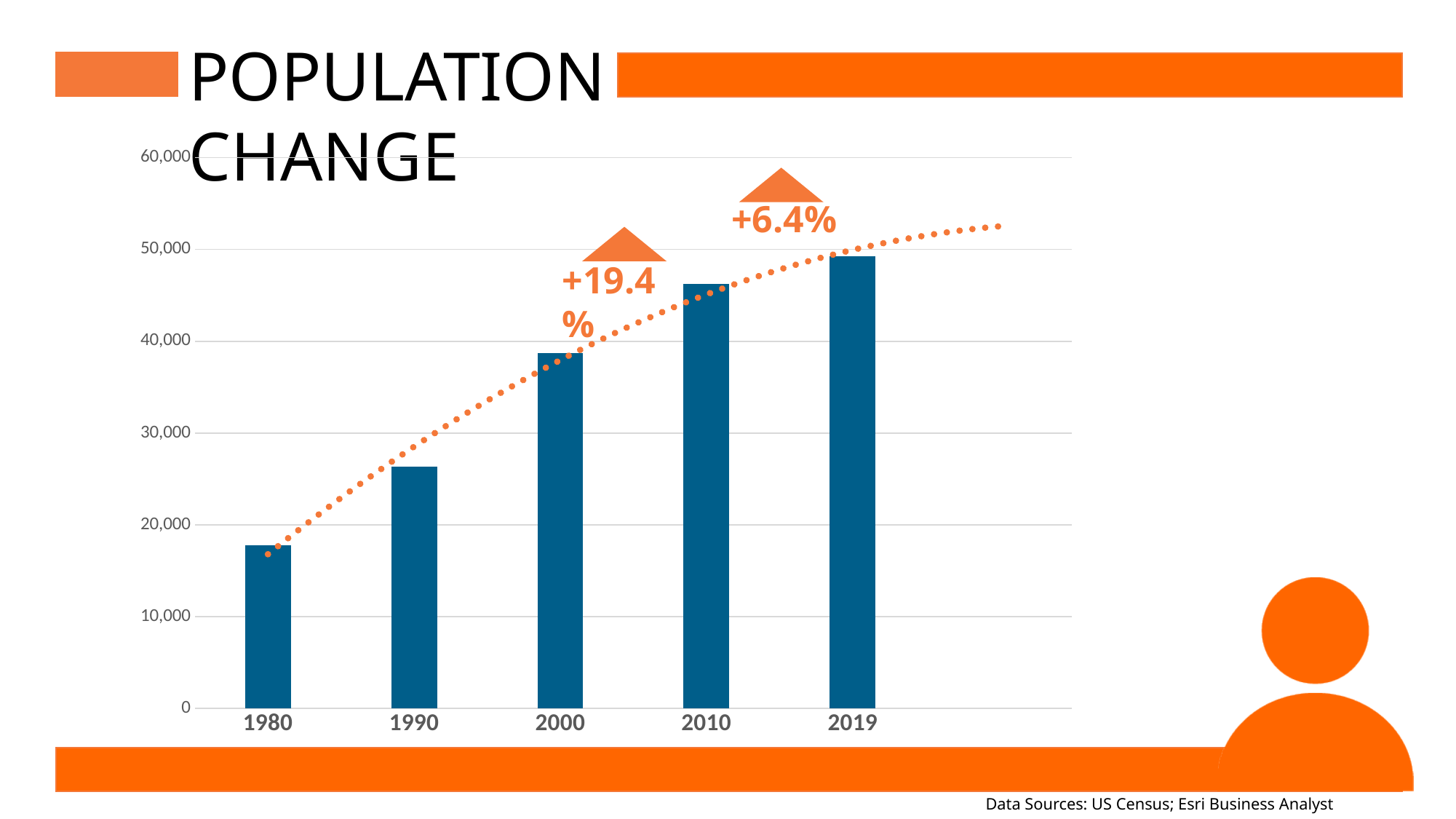
What kind of chart is shown on the slide? bar chart Do the population values rise or fall from 1980 to 2019? rise Is the value for 1980 greater or less than 20,000? less How many years are shown on the x axis of the chart? 5 Is the value for 2010 greater or less than 40,000? greater What is the title of the slide containing the chart? POPULATION CHANGE Which year has the lowest population bar? 1980 Which is larger, the value for 1990 or the value for 2010? 2010 Which year has the highest population bar? 2019 What percentage change is annotated between the 2010 and 2019 bars? +6.4% Is the value for 2000 greater or less than 40,000? less